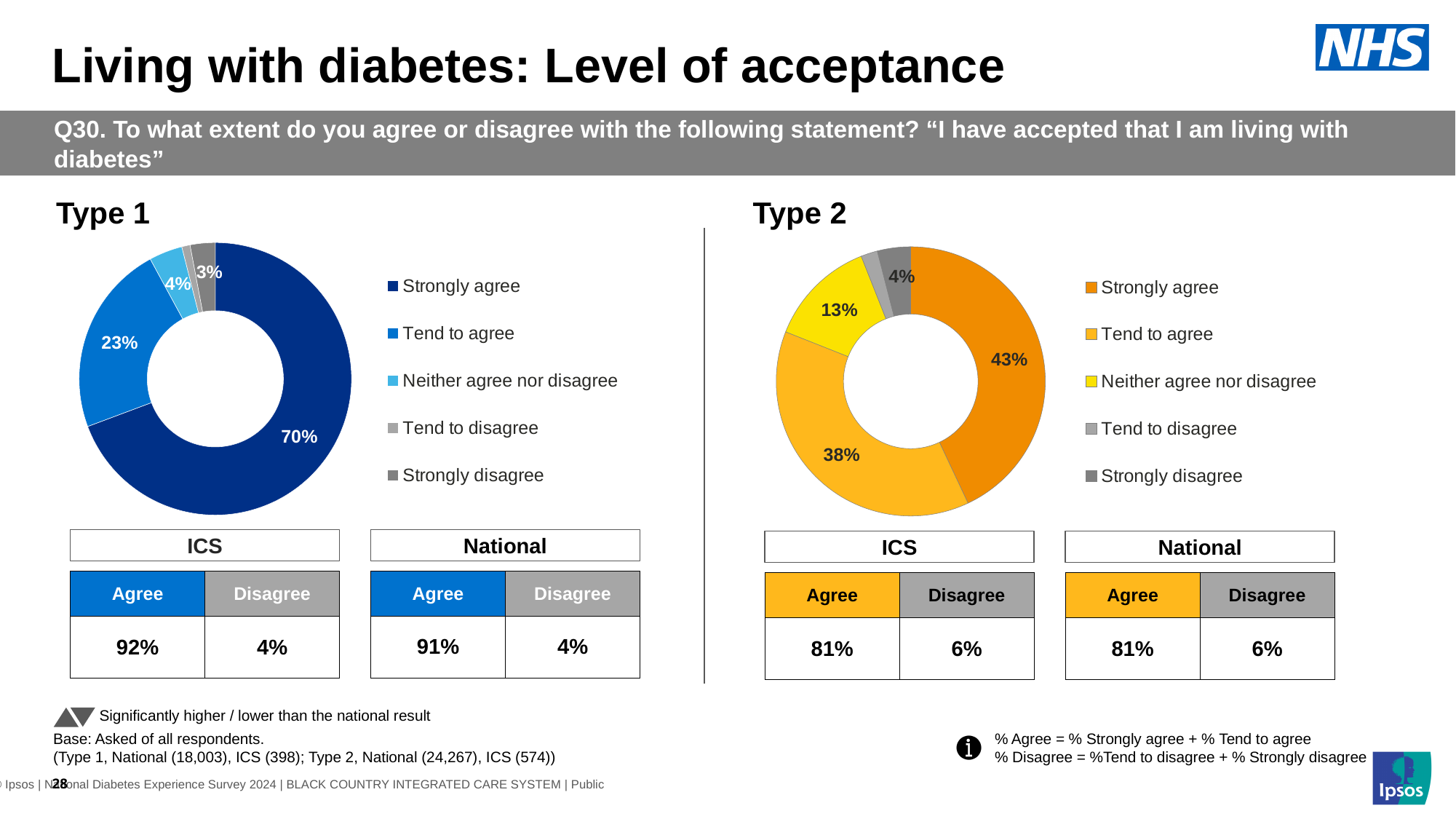
In the Type 1 chart, what is the difference in percentage points between Strongly agree and Tend to agree? 47 percentage points In the Type 2 chart, what is the difference in percentage points between Strongly agree and Tend to agree? 5 percentage points In the Type 2 chart, which response category has the largest share? Strongly agree In the Type 2 chart, what percentage of respondents strongly agree? 43% In the Type 2 chart, what percentage of respondents tend to agree? 38% How many response categories does the legend of the Type 1 chart list? 5 In the Type 1 chart, what percentage neither agree nor disagree? 4% Which chart has the larger share of Strongly agree, Type 1 or Type 2? Type 1 In the Type 1 chart, what percentage of respondents strongly agree? 70% In the Type 2 chart, what percentage neither agree nor disagree? 13% In the Type 1 chart, what percentage of respondents tend to agree? 23% What kind of chart is used to show the Type 2 results? Pie (donut) chart